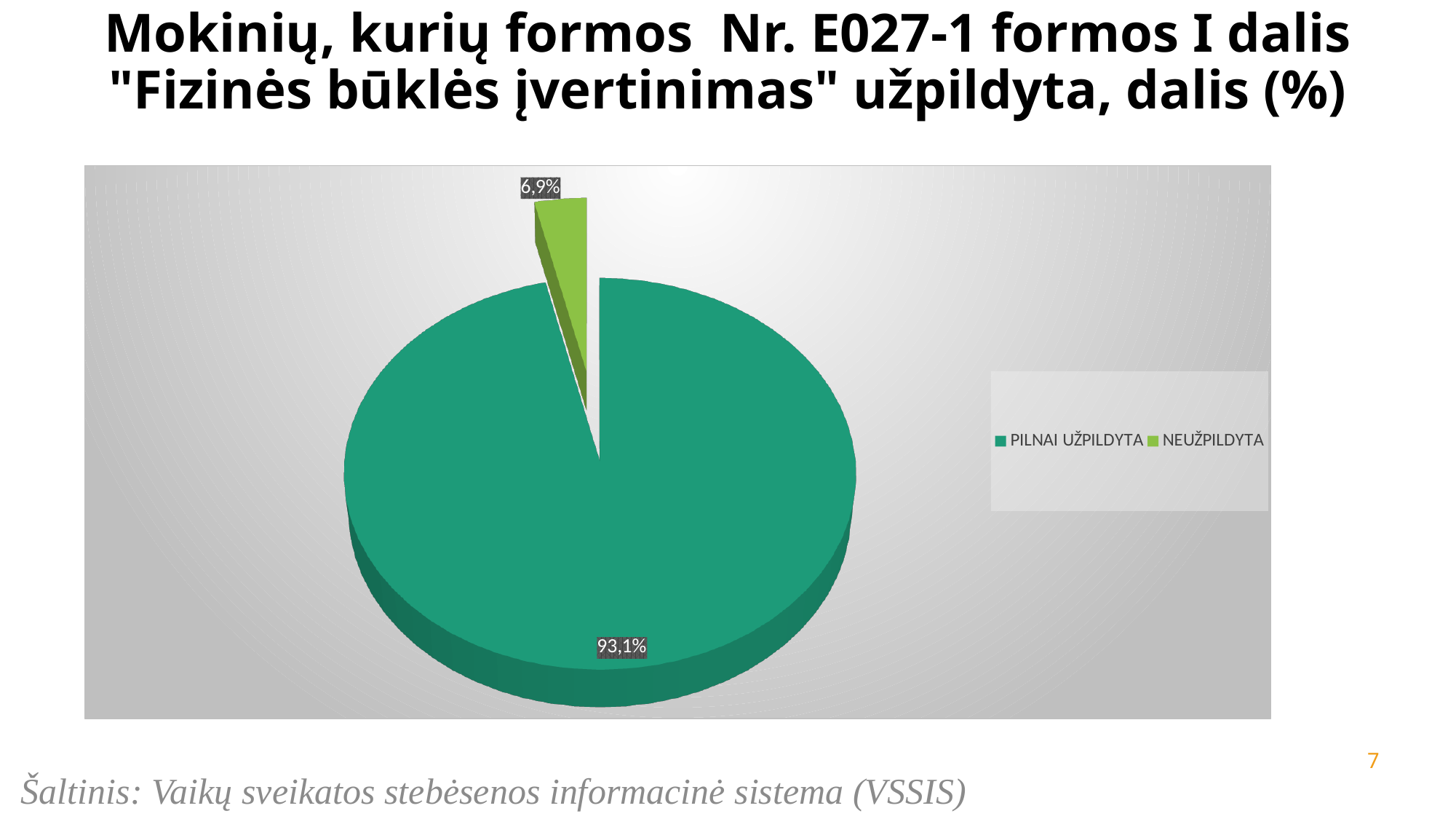
Which slice of the pie is the largest? PILNAI UŽPILDYTA What share of the pie is labelled PILNAI UŽPILDYTA? 93,1% How many entries does the legend list? 2 What kind of chart is shown on the slide? pie chart What colour is the PILNAI UŽPILDYTA slice? teal green What share of the pie is labelled NEUŽPILDYTA? 6,9% How many slices does the pie chart have? 2 Which is larger, the PILNAI UŽPILDYTA slice or the NEUŽPILDYTA slice? PILNAI UŽPILDYTA What is the difference in percentage points between the PILNAI UŽPILDYTA and NEUŽPILDYTA slices? 86,2 What source is cited below the chart? Vaikų sveikatos stebėsenos informacinė sistema (VSSIS) Which slice of the pie is the smallest? NEUŽPILDYTA